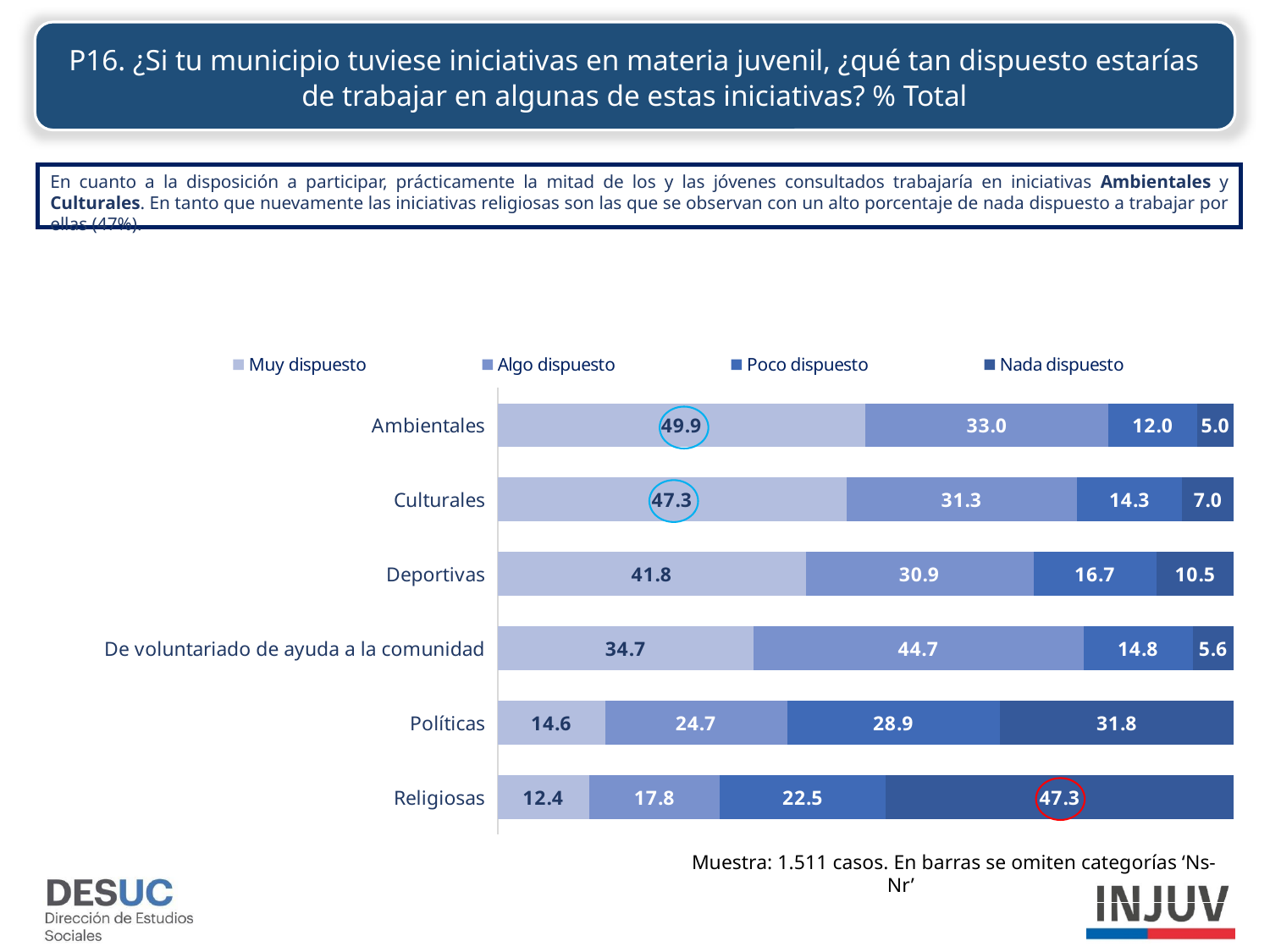
What is the 'Algo dispuesto' value for De voluntariado de ayuda a la comunidad? 44.7 How many series does the legend list? 4 What type of chart is shown on the slide? Stacked bar chart Which category has the lowest 'Nada dispuesto' value? Ambientales What is the 'Nada dispuesto' value for Religiosas? 47.3 Which category has the highest 'Muy dispuesto' value? Ambientales How many categories are plotted on the chart? 6 Which legend entry is shown in the darkest blue? Nada dispuesto What is the 'Muy dispuesto' value for Ambientales? 49.9 What is the difference between the 'Muy dispuesto' values for Ambientales and Culturales? 2.6 What is the total of the stacked bar for Políticas? 100.0 Which is larger: the 'Poco dispuesto' value for Políticas or for Deportivas? Políticas